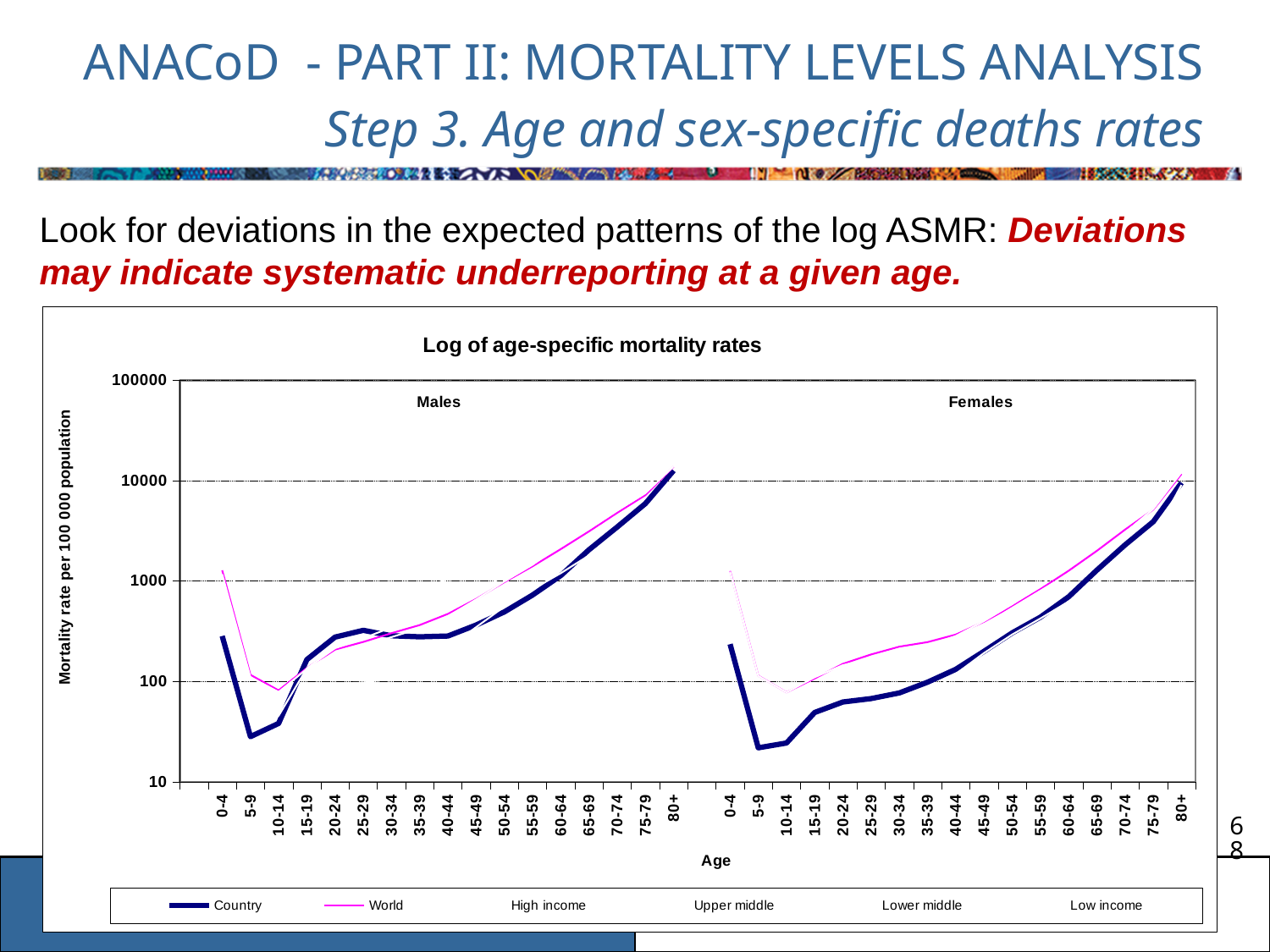
Is the World value for males aged 0-4 greater or less than 1000? greater What is the title of the chart? Log of age-specific mortality rates What kind of chart is shown on the slide? line chart Is the Country value for males aged 5-9 greater or less than 100? less Does the Country line for males rise or fall from age 15-19 to age 80+? rise For males aged 5-9, which is higher, the Country line or the World line? World How many entries does the chart legend list? 6 For females aged 0-4, which is higher, the Country line or the World line? World Is the Country value for females aged 5-9 greater or less than 100? less How many age groups are plotted on the x axis for the Males panel? 17